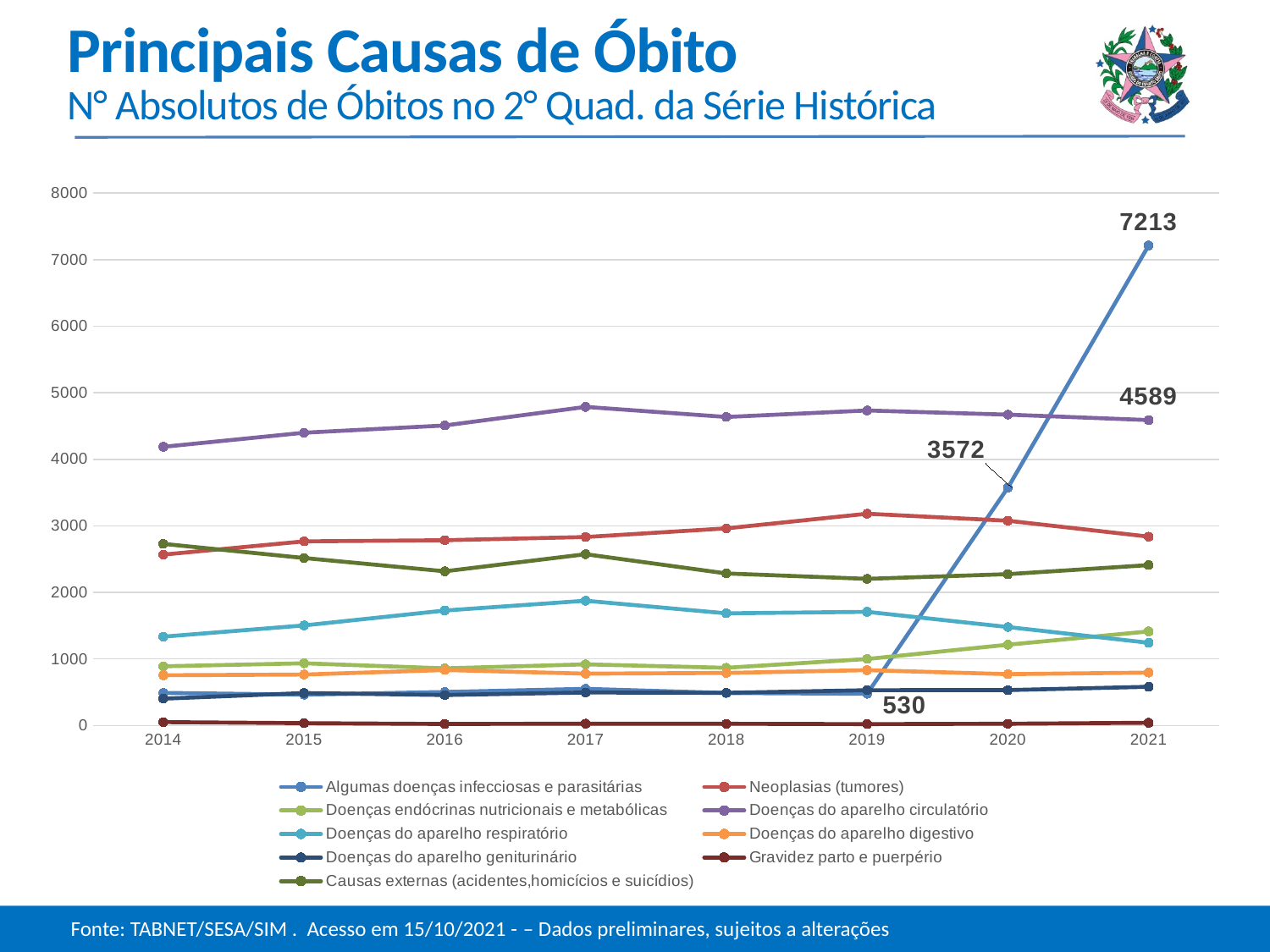
How many series does the legend list? 9 Is the value for Neoplasias (tumores) in 2019 greater or less than 3000? greater Which series has the lowest values across the whole period? Gravidez parto e puerpério What is the value for Doenças do aparelho circulatório in 2021? 4589 Which series has the highest value in 2021? Algumas doenças infecciosas e parasitárias In 2021, what is the difference between Algumas doenças infecciosas e parasitárias and Doenças do aparelho circulatório? 2624 What is the value for Algumas doenças infecciosas e parasitárias in 2021? 7213 What is the value for Algumas doenças infecciosas e parasitárias in 2020? 3572 By how much did Algumas doenças infecciosas e parasitárias increase from 2020 to 2021? 3641 What kind of chart is shown on the slide? line chart How many years are shown on the x axis? 8